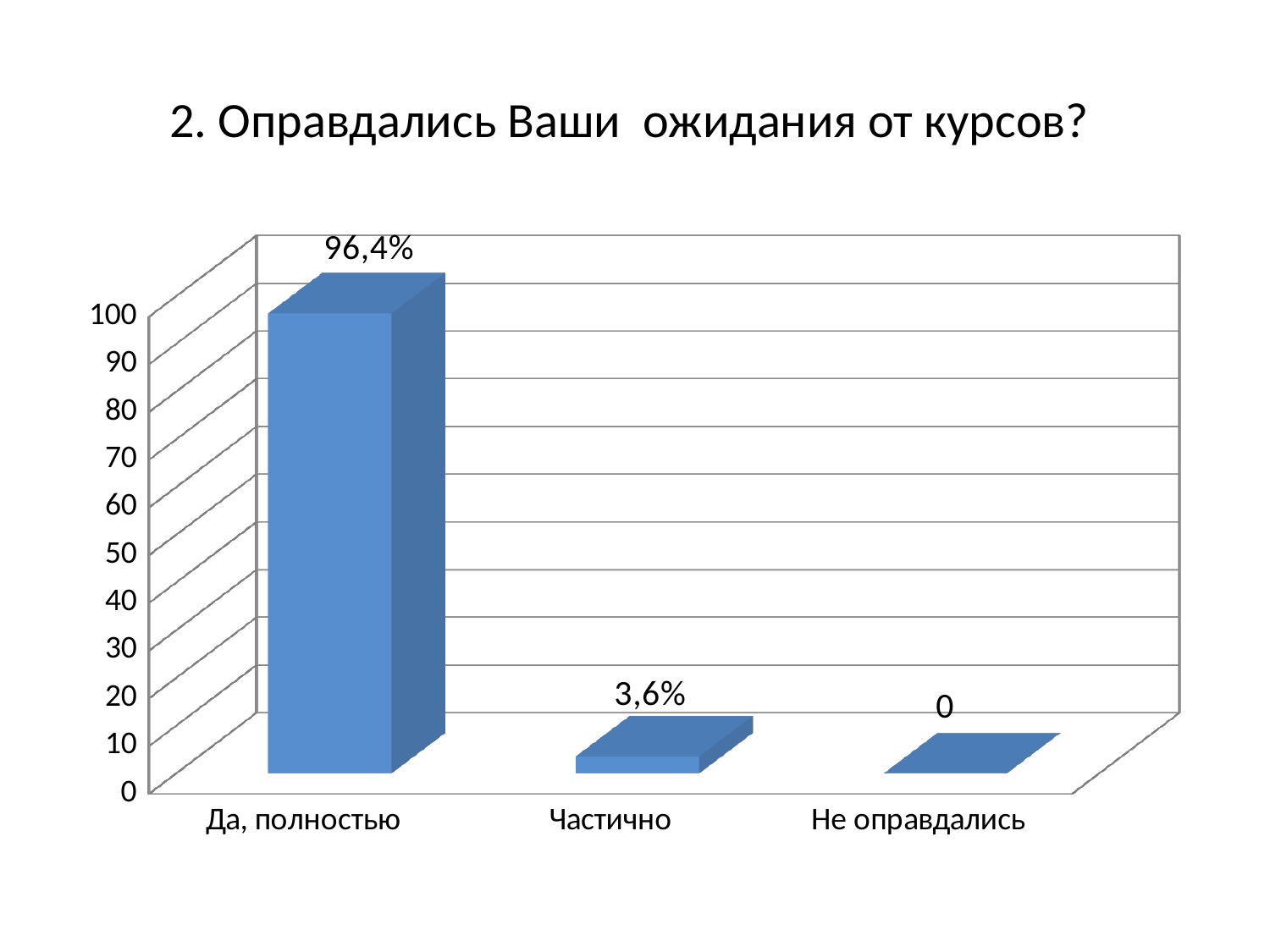
Is the value for "Частично" greater or less than 10? less How many categories are shown on the chart? 3 What kind of chart is shown on the slide? bar chart What is the value for "Частично"? 3,6% What is the value for "Не оправдались"? 0 Which is larger, the value for "Частично" or the value for "Не оправдались"? Частично Which category has the lowest value? Не оправдались Is the value for "Да, полностью" greater or less than 90? greater What is the value for "Да, полностью"? 96,4% What is the title of the slide? 2. Оправдались Ваши ожидания от курсов? What is the difference between the values for "Да, полностью" and "Частично"? 92,8% Which category has the highest value? Да, полностью